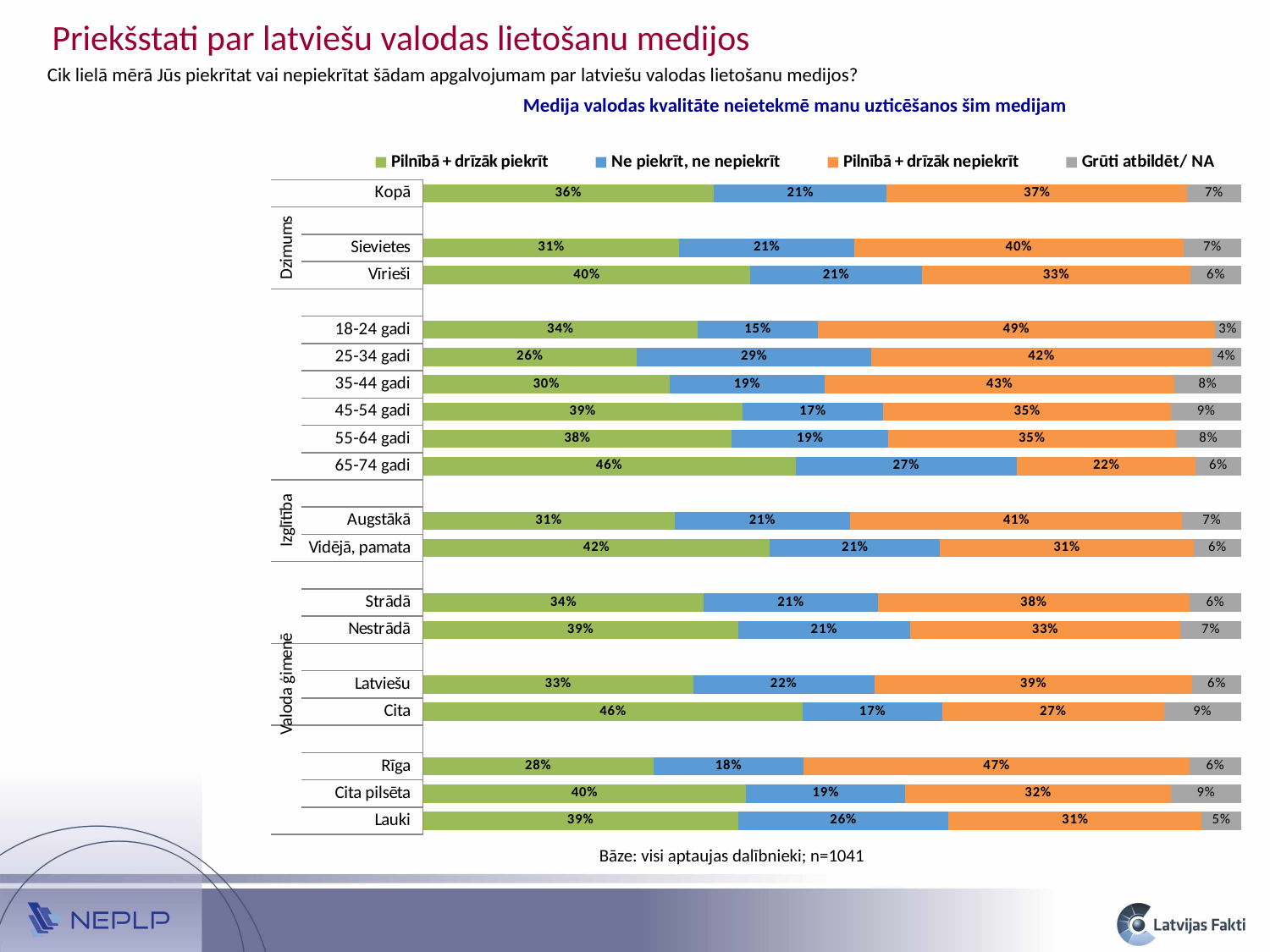
What is the value of "Ne piekrīt, ne nepiekrīt" for 25-34 gadi? 29% What is the value of "Pilnībā + drīzāk nepiekrīt" for Rīga? 47% How many series does the legend list? 4 Which is larger: the "Pilnībā + drīzāk piekrīt" value for Vīrieši or for Sievietes? Vīrieši What is the value of "Pilnībā + drīzāk piekrīt" for Kopā? 36% What is the title of the statement shown above the chart? Medija valodas kvalitāte neietekmē manu uzticēšanos šim medijam What kind of chart is shown on the slide? Stacked bar chart What is the difference between the "Pilnībā + drīzāk nepiekrīt" values for Rīga and Lauki? 16 percentage points Which category has the highest value for "Pilnībā + drīzāk nepiekrīt"? 18-24 gadi What is the value of "Grūti atbildēt/ NA" for 18-24 gadi? 3% Which category has the lowest value for "Pilnībā + drīzāk piekrīt"? 25-34 gadi How many categories (rows) are plotted in the chart? 18